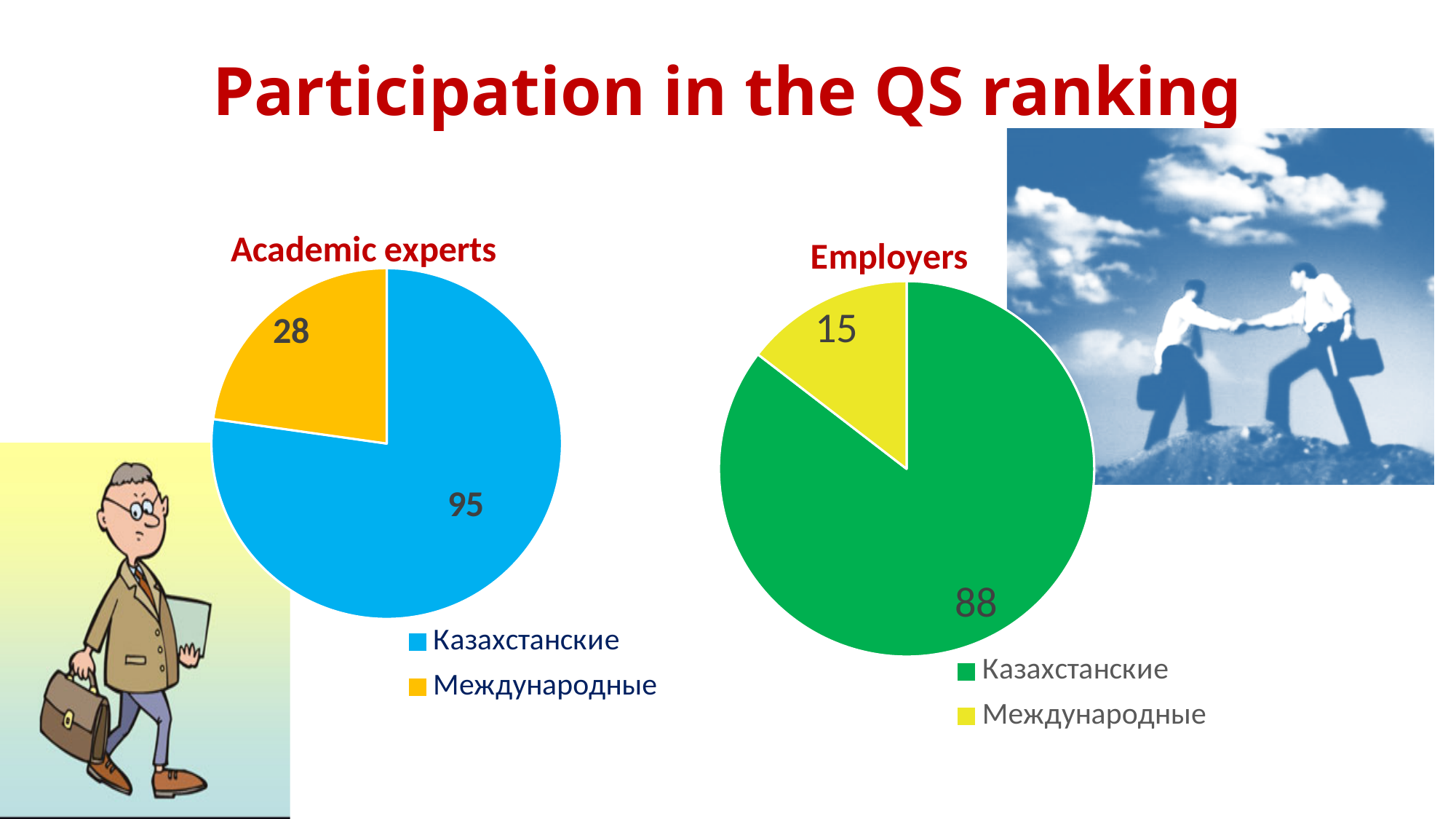
What type of chart is the Employers chart? Pie chart What colour is the Казахстанские slice in the Employers chart? Green How many categories does the Academic experts chart show? 2 In the Academic experts chart, what is the value for Международные? 28 In the Employers chart, what is the value for Казахстанские? 88 In the Employers chart, what is the value for Международные? 15 In the Academic experts chart, what is the difference between the Казахстанские and Международные values? 67 In the Employers chart, which category has the smallest slice? Международные In the Academic experts chart, what is the value for Казахстанские? 95 In the Academic experts chart, which category has the largest slice? Казахстанские Which is larger: the Международные value in the Academic experts chart or the Международные value in the Employers chart? Academic experts In the Employers chart, what is the difference between the Казахстанские and Международные values? 73